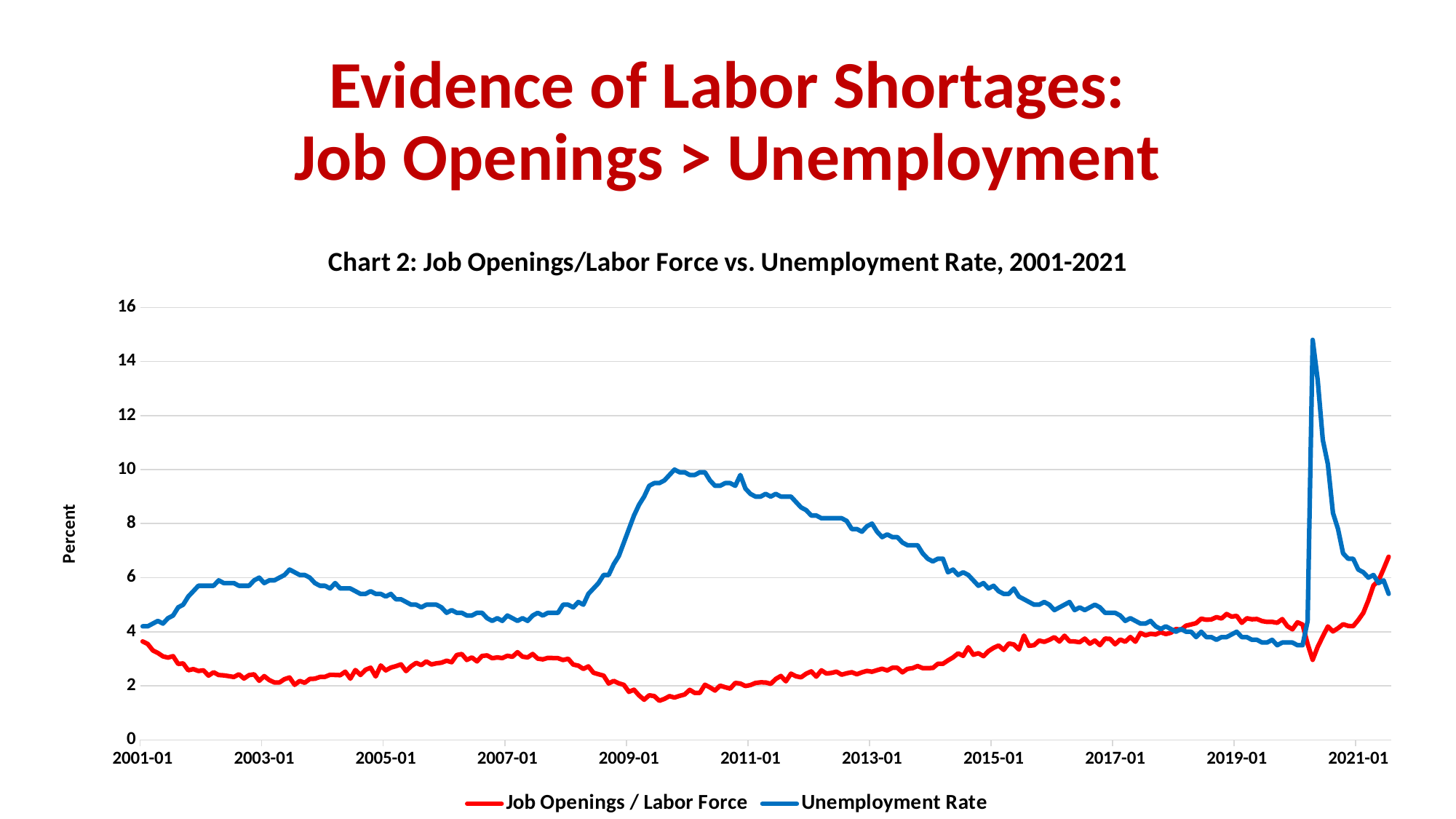
Is the Unemployment Rate at its 2009-2010 peak greater or less than 8? greater Is the value for Job Openings / Labor Force at 2017-01 greater or less than 2? greater Is the peak value of the Unemployment Rate in 2020 greater or less than 14? greater What kind of chart is shown on the slide? Line chart At 2011-01, which series has the higher value, Job Openings / Labor Force or Unemployment Rate? Unemployment Rate What is the title of the chart? Chart 2: Job Openings/Labor Force vs. Unemployment Rate, 2001-2021 What is the label on the vertical axis? Percent How many series does the legend list? 2 Which series reaches the highest value anywhere on the chart? Unemployment Rate Does the Unemployment Rate rise or fall between 2011-01 and 2019-01? fall